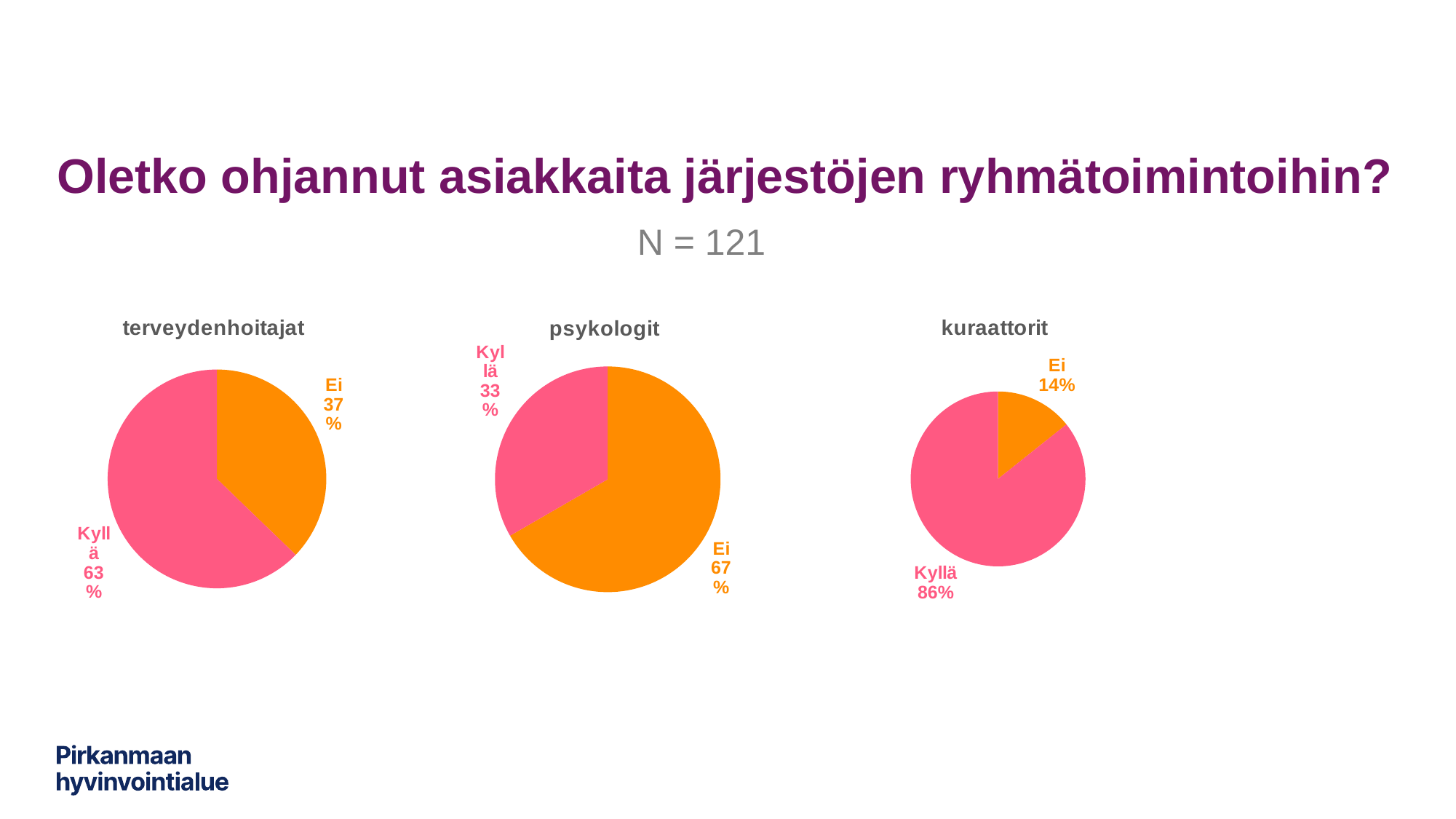
In the 'terveydenhoitajat' chart, what is the value for 'Ei'? 37% In the 'kuraattorit' chart, what is the difference between 'Kyllä' and 'Ei'? 72% What kind of chart is the 'psykologit' chart? Pie chart In the 'terveydenhoitajat' chart, which is larger, 'Kyllä' or 'Ei'? Kyllä In the 'psykologit' chart, what is the value for 'Kyllä'? 33% In the 'psykologit' chart, what share of the pie is 'Ei'? 67% How many pie charts are shown on the slide? 3 In the 'kuraattorit' chart, what is the value for 'Ei'? 14% In the 'kuraattorit' chart, which slice is the smallest? Ei In the 'terveydenhoitajat' chart, what share of the pie is 'Kyllä'? 63% In the 'kuraattorit' chart, what share of the pie is 'Kyllä'? 86% In the 'psykologit' chart, which slice is the largest? Ei